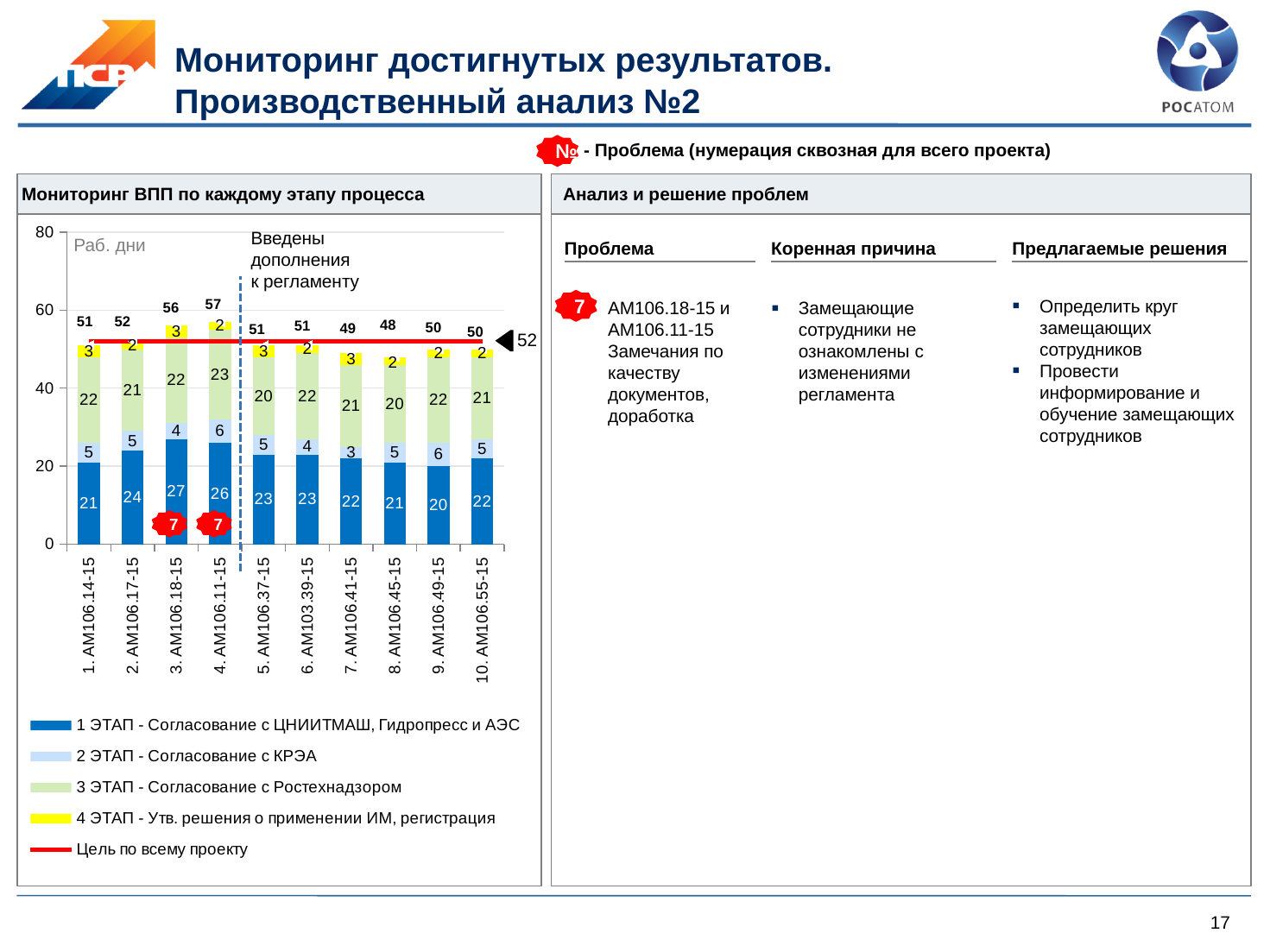
Which has a larger total value: 3. АМ106.18-15 or 7. АМ106.41-15? 3. АМ106.18-15 What is the difference between the total values for 4. АМ106.11-15 and 8. АМ106.45-15? 9 Which category has the highest total value in the chart? 4. АМ106.11-15 Which category has the lowest total value in the chart? 8. АМ106.45-15 What is the value of the '1 ЭТАП - Согласование с ЦНИИТМАШ, Гидропресс и АЭС' segment for 3. АМ106.18-15? 27 What value is marked for the 'Цель по всему проекту' line on the chart? 52 What is the value of the '3 ЭТАП - Согласование с Ростехнадзором' segment for 4. АМ106.11-15? 23 How many categories (documents) are plotted along the x axis of the chart? 10 What is the value of the '2 ЭТАП - Согласование с КРЭА' segment for 9. АМ106.49-15? 6 What is the total value (in working days) shown above the bar for 4. АМ106.11-15? 57 How many entries does the chart legend list? 5 What kind of chart is shown on the slide? stacked bar chart